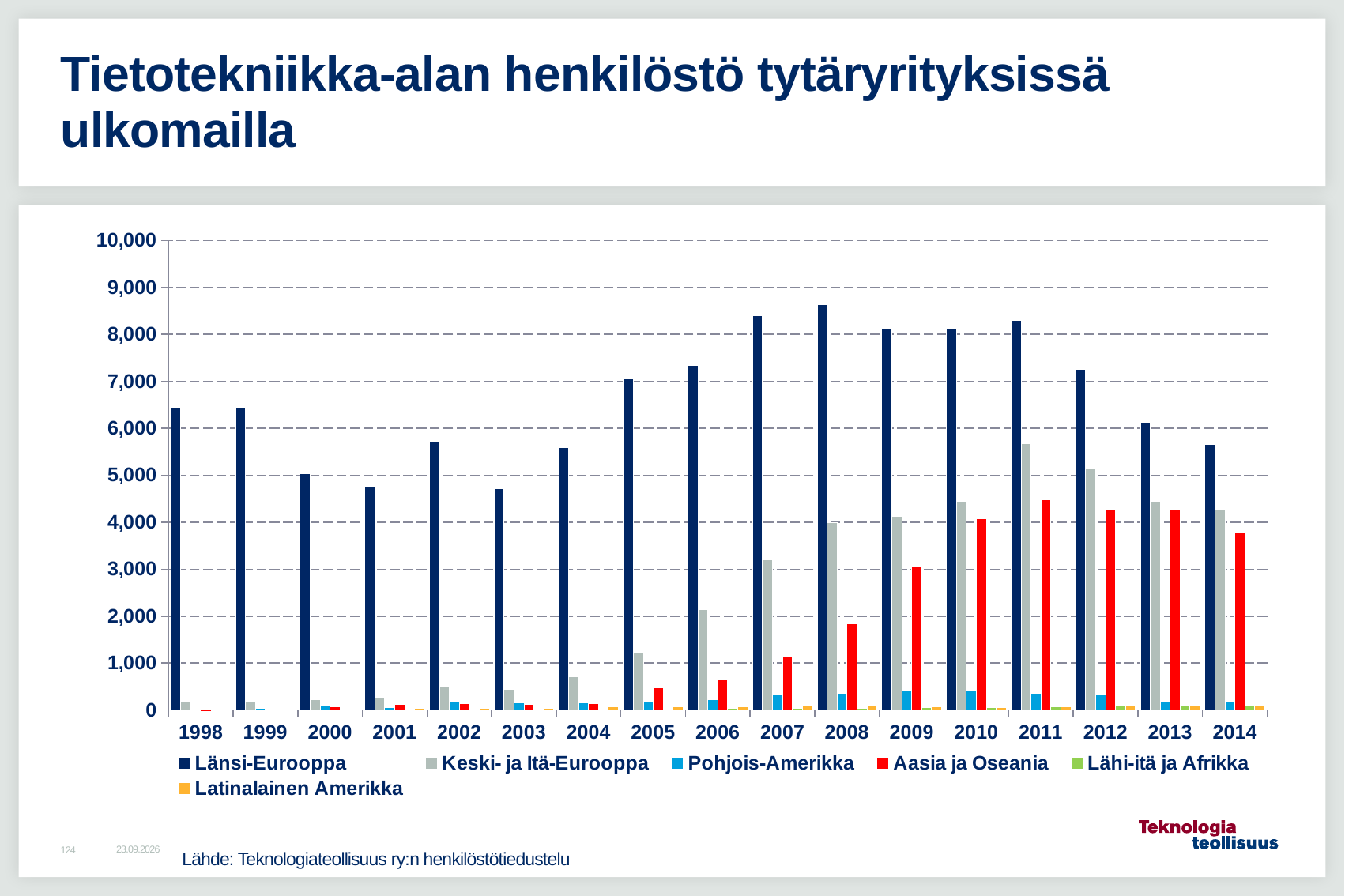
In which year is the value for Länsi-Eurooppa highest? 2008 Which is larger for Länsi-Eurooppa: the value in 2007 or the value in 2014? 2007 In 2014, which is larger: Keski- ja Itä-Eurooppa or Aasia ja Oseania? Keski- ja Itä-Eurooppa How many series does the legend list? 6 What kind of chart is shown on the slide? bar chart In which year is the value for Keski- ja Itä-Eurooppa highest? 2011 What colour represents Aasia ja Oseania in the chart? red Is the value for Aasia ja Oseania in 2014 greater or less than 4,000? less Is the value for Länsi-Eurooppa in 2003 greater or less than 5,000? less Does the value for Länsi-Eurooppa rise or fall from 2011 to 2014? fall How many years are shown on the x axis? 17 Is the value for Länsi-Eurooppa in 2008 greater or less than 8,000? greater